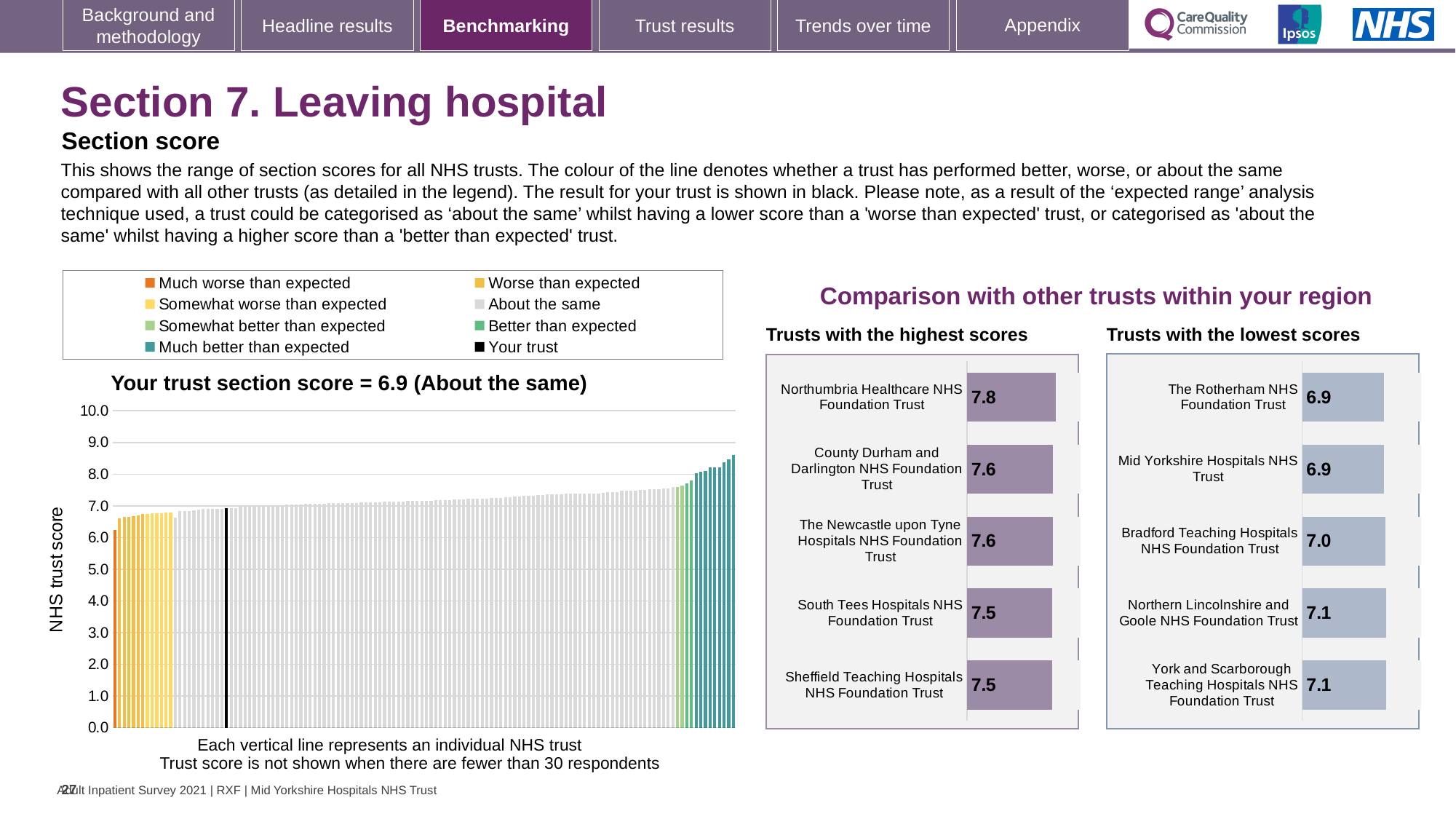
In the main chart of all NHS trusts, what is the section score for your trust? 6.9 In the 'Trusts with the lowest scores' chart, which is larger: the score for Bradford Teaching Hospitals NHS Foundation Trust or the score for Mid Yorkshire Hospitals NHS Trust? Bradford Teaching Hospitals NHS Foundation Trust In the 'Trusts with the highest scores' chart, what is the difference between the scores of Northumbria Healthcare NHS Foundation Trust and Sheffield Teaching Hospitals NHS Foundation Trust? 0.3 In the 'Trusts with the lowest scores' chart, what is the score for Bradford Teaching Hospitals NHS Foundation Trust? 7.0 In the 'Trusts with the highest scores' chart, which trust has the highest score? Northumbria Healthcare NHS Foundation Trust In the 'Trusts with the highest scores' chart, what is the score for Northumbria Healthcare NHS Foundation Trust? 7.8 In the main chart of all NHS trusts, is the value of the tallest bar greater or less than 8.0? greater In the main chart of all NHS trusts, do the bar values rise or fall from left to right? rise In the 'Trusts with the lowest scores' chart, what is the score for York and Scarborough Teaching Hospitals NHS Foundation Trust? 7.1 How many trusts are listed in the 'Trusts with the lowest scores' chart? 5 How many entries does the legend above the main chart of all NHS trusts list? 8 In the 'Trusts with the highest scores' chart, what is the score for South Tees Hospitals NHS Foundation Trust? 7.5